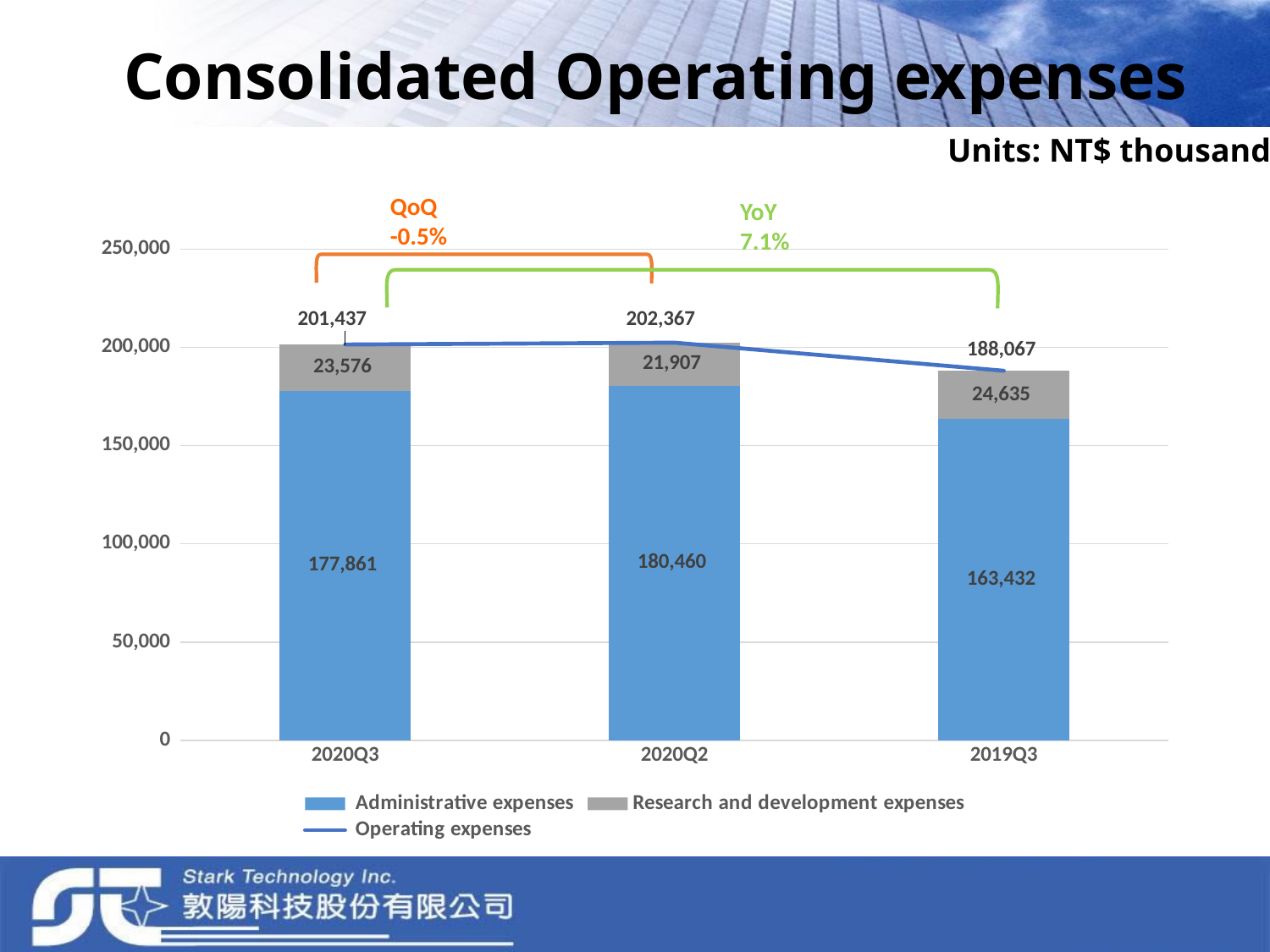
What is the total of the stacked bar for 2019Q3? 188,067 What is the value of Operating expenses for 2020Q2? 202,367 What QoQ change percentage is annotated on the chart? -0.5% How many series does the legend list? 3 Which is larger, Research and development expenses in 2020Q3 or in 2019Q3? 2019Q3 What is the value of Administrative expenses for 2020Q3? 177,861 How many quarters are shown on the x axis? 3 Which quarter has the lowest Research and development expenses? 2020Q2 Which quarter has the highest Administrative expenses? 2020Q2 What is the difference in Administrative expenses between 2020Q2 and 2020Q3? 2,599 Is the value of Administrative expenses for 2019Q3 greater or less than 150,000? greater What is the value of Research and development expenses for 2019Q3? 24,635